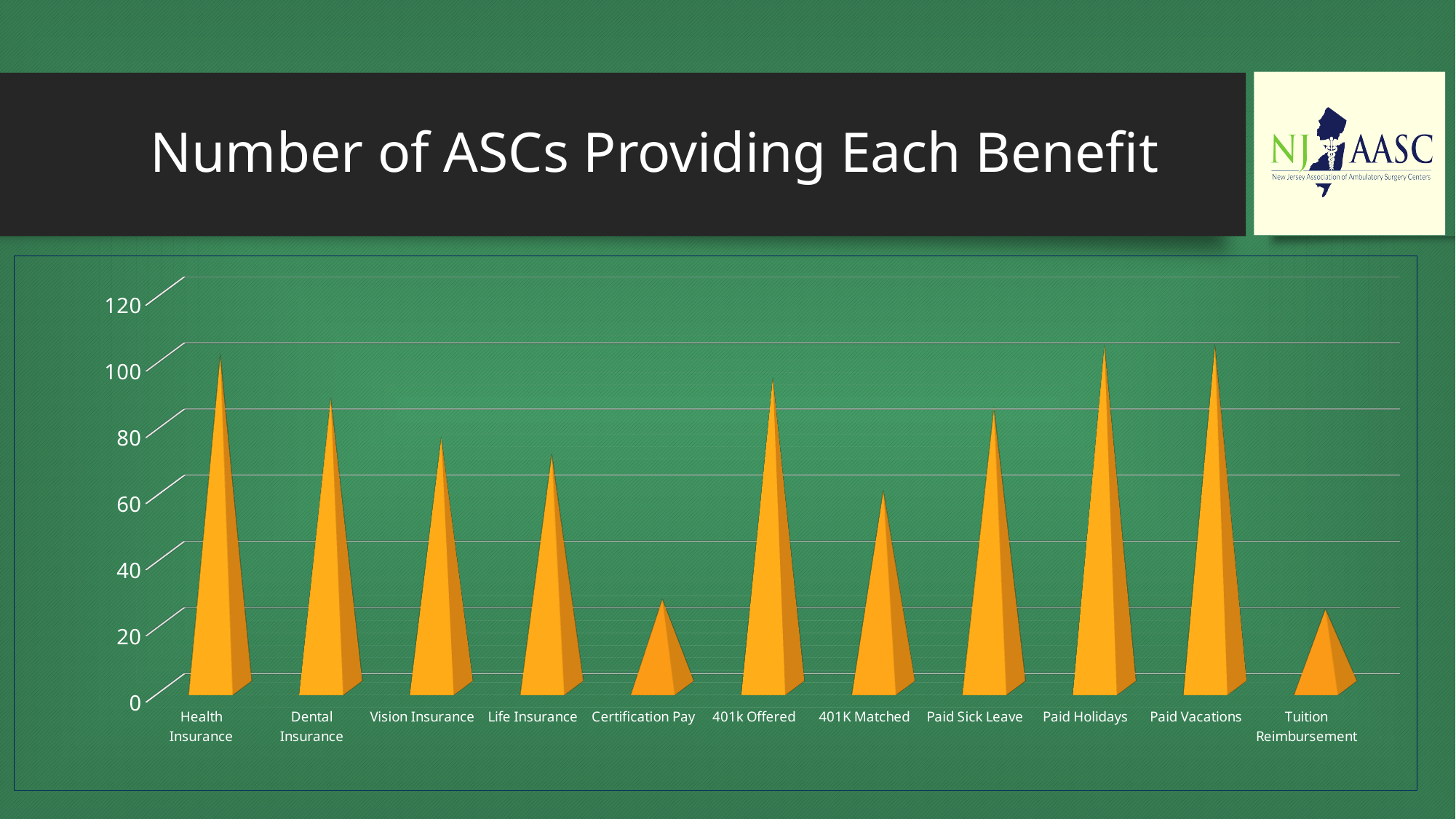
Which is larger, the value for 401k Offered or the value for 401K Matched? 401k Offered Is the value for Certification Pay greater or less than 40? less Is the value for 401K Matched greater or less than 40? greater How many benefit categories are shown on the x axis? 11 Which is larger, the value for Health Insurance or the value for Certification Pay? Health Insurance Is the value for Life Insurance greater or less than 100? less What colour are the bars in the chart? Orange What kind of chart is shown on the slide? Bar chart What is the title of the chart? Number of ASCs Providing Each Benefit Which is larger, the value for Paid Sick Leave or the value for Tuition Reimbursement? Paid Sick Leave